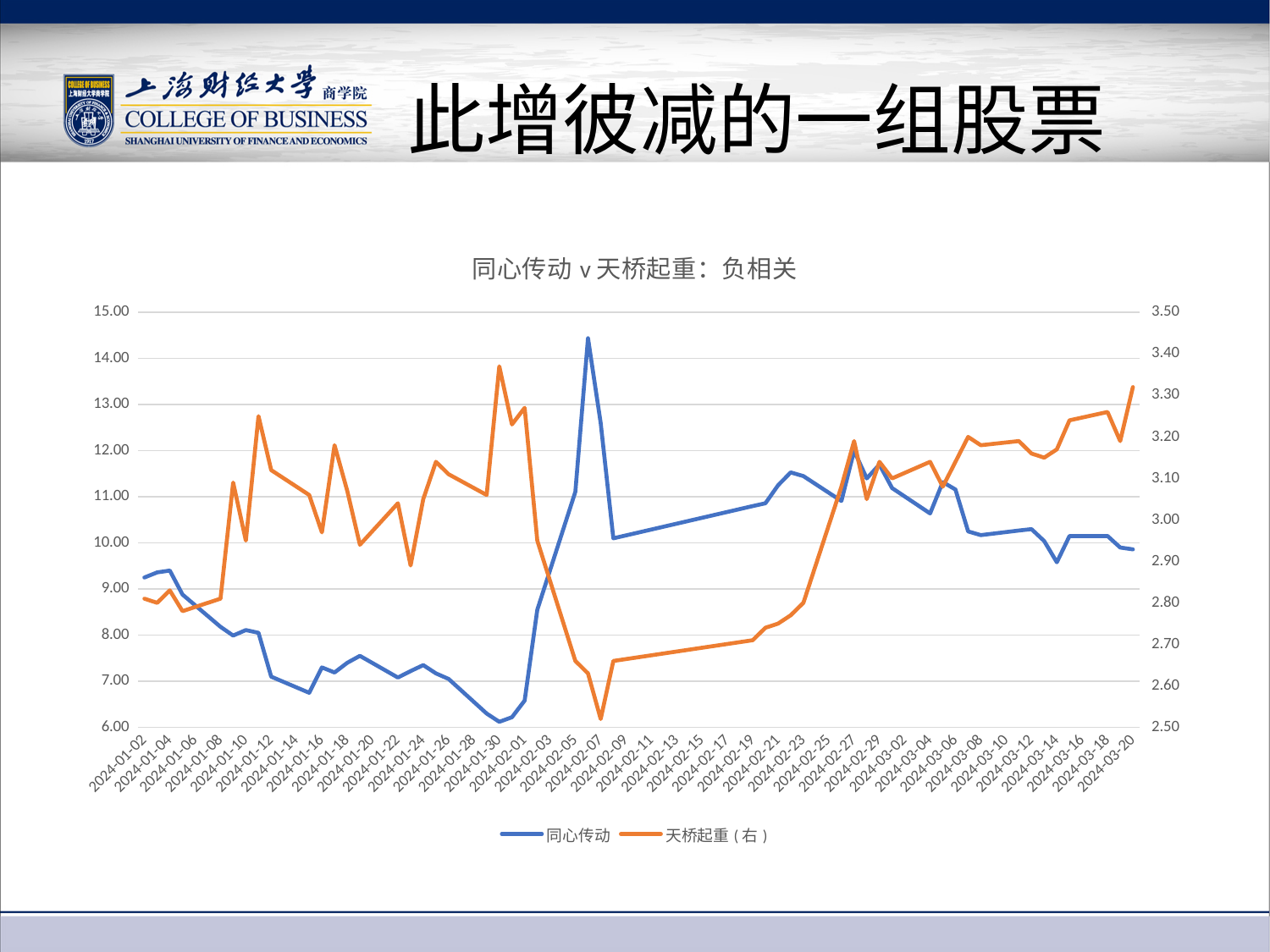
On which date does 天桥起重 reach its lowest value? 2024-02-07 Is the value for 天桥起重 on 2024-02-07 greater or less than 2.60? less Is the value for 天桥起重 on 2024-03-20 greater or less than 3.20? greater How many series does the legend list? 2 Is the value for 同心传动 on 2024-01-30 greater or less than 7.00? less Which series is plotted against the right-hand axis? 天桥起重（右） Does the 天桥起重 series generally rise or fall from 2024-02-07 to 2024-03-20? rise What kind of chart is shown on the slide? line chart What is the title of the chart? 同心传动 v 天桥起重：负相关 Which is larger for 同心传动: the value on 2024-02-07 or the value on 2024-01-30? 2024-02-07